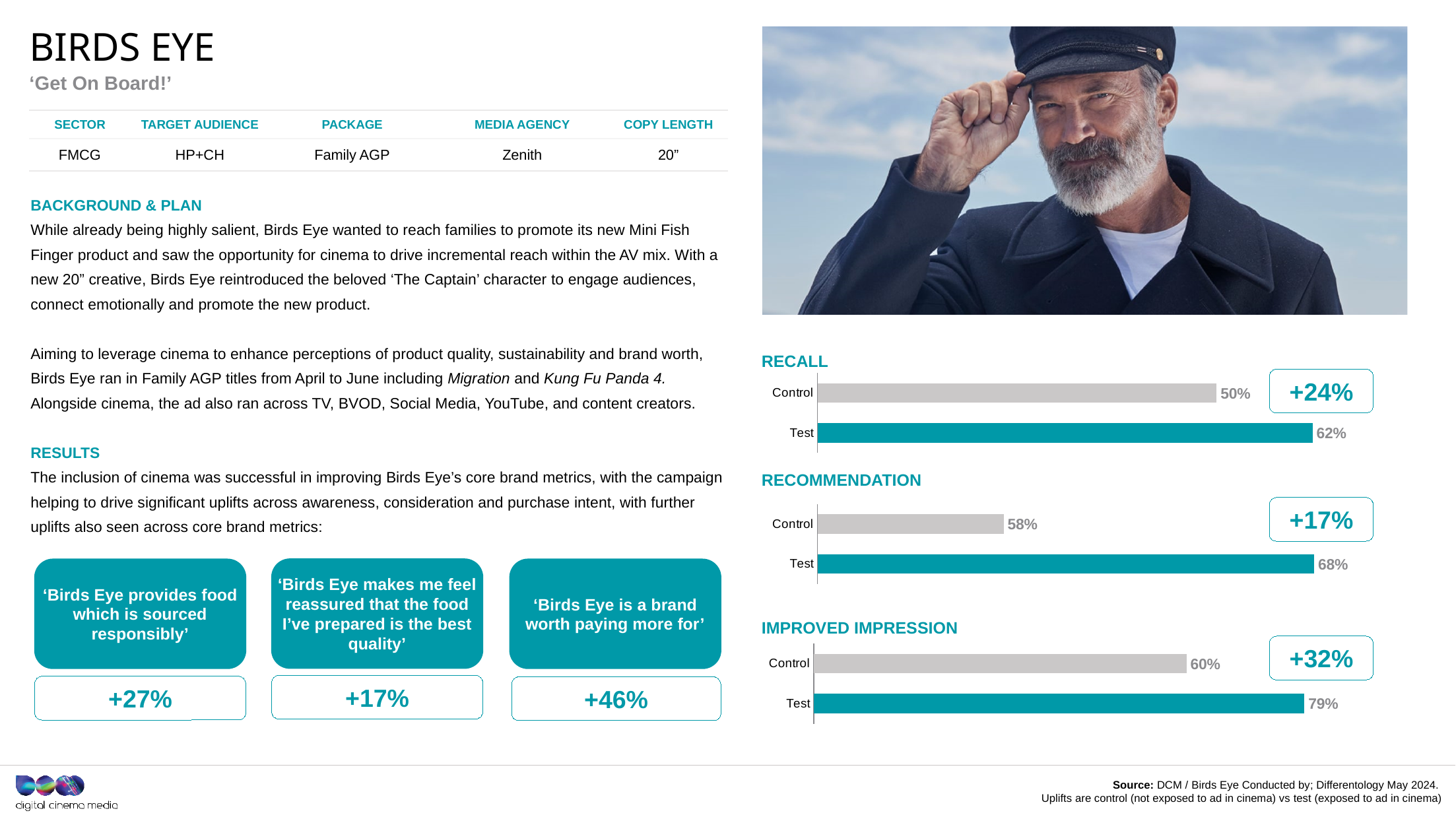
In the Improved Impression chart, what is the difference between the Test and Control values? 19% In the Recommendation chart, what is the value for Test? 68% In the Improved Impression chart, which bar is the highest? Test In the Recall chart, what is the difference between the Test and Control values? 12% In the Recommendation chart, what is the value for Control? 58% In the Recommendation chart, which is larger, Control or Test? Test In the Improved Impression chart, what is the value for Control? 60% How many bars are shown in the Recall chart? 2 In the Recall chart, what is the value for Test? 62% In the Improved Impression chart, what is the value for Test? 79% What kind of chart is the Recommendation chart? Bar chart In the Recall chart, what is the value for Control? 50%